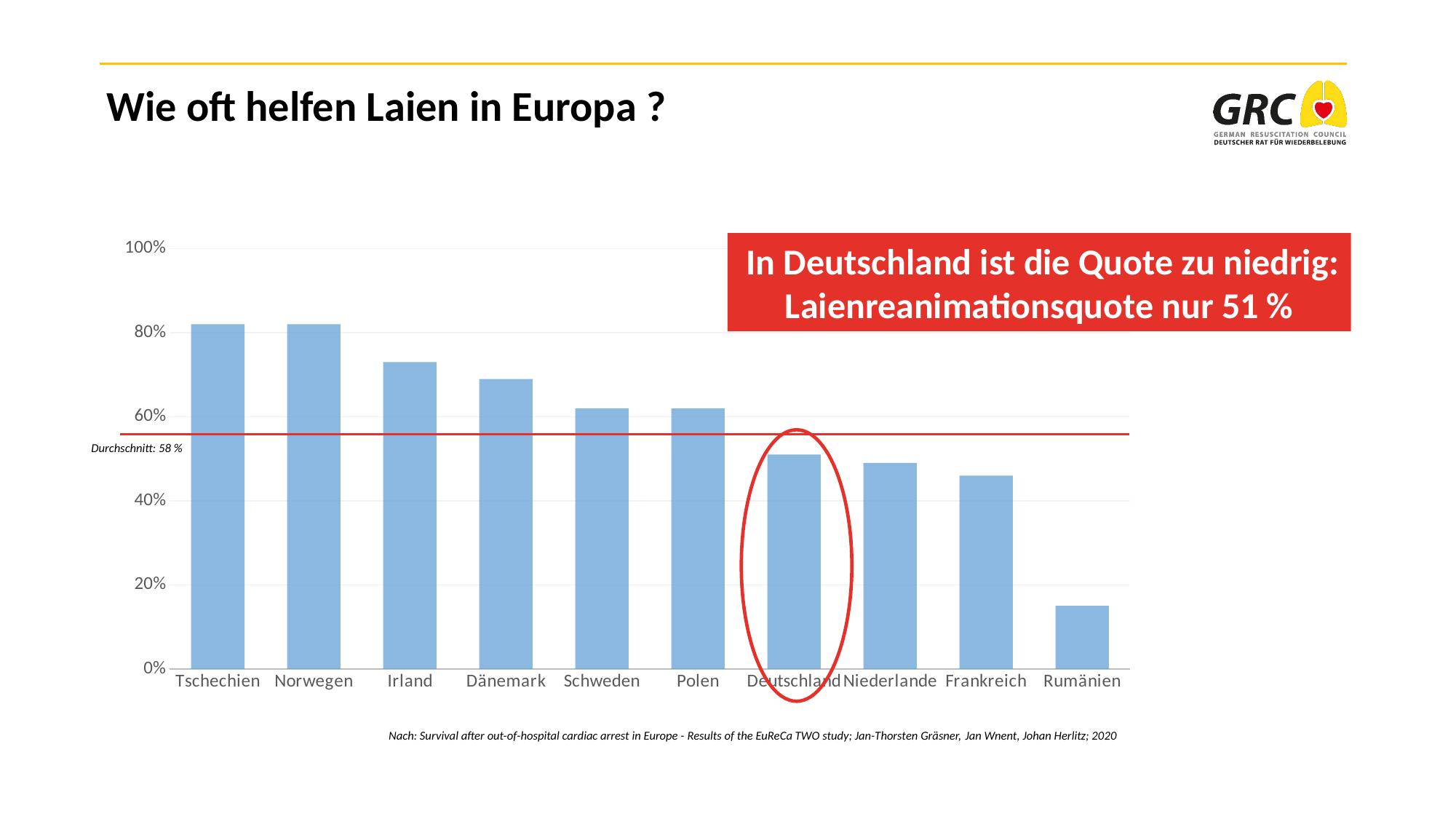
Which has the larger value, Irland or Frankreich? Irland Is the value for Frankreich greater or less than 60%? less Is the value for Niederlande greater or less than 40%? greater Is the value for Irland greater or less than 60%? greater What average value (Durchschnitt) is marked by the red horizontal line in the chart? 58 % Which has the larger value, Polen or Rumänien? Polen Which country has the lowest value in the chart? Rumänien What is the Laienreanimationsquote for Deutschland according to the slide? 51 % Do the bar values generally rise or fall from left to right along the x axis? fall How many countries are shown on the x axis of the chart? 10 What kind of chart is shown on the slide? bar chart